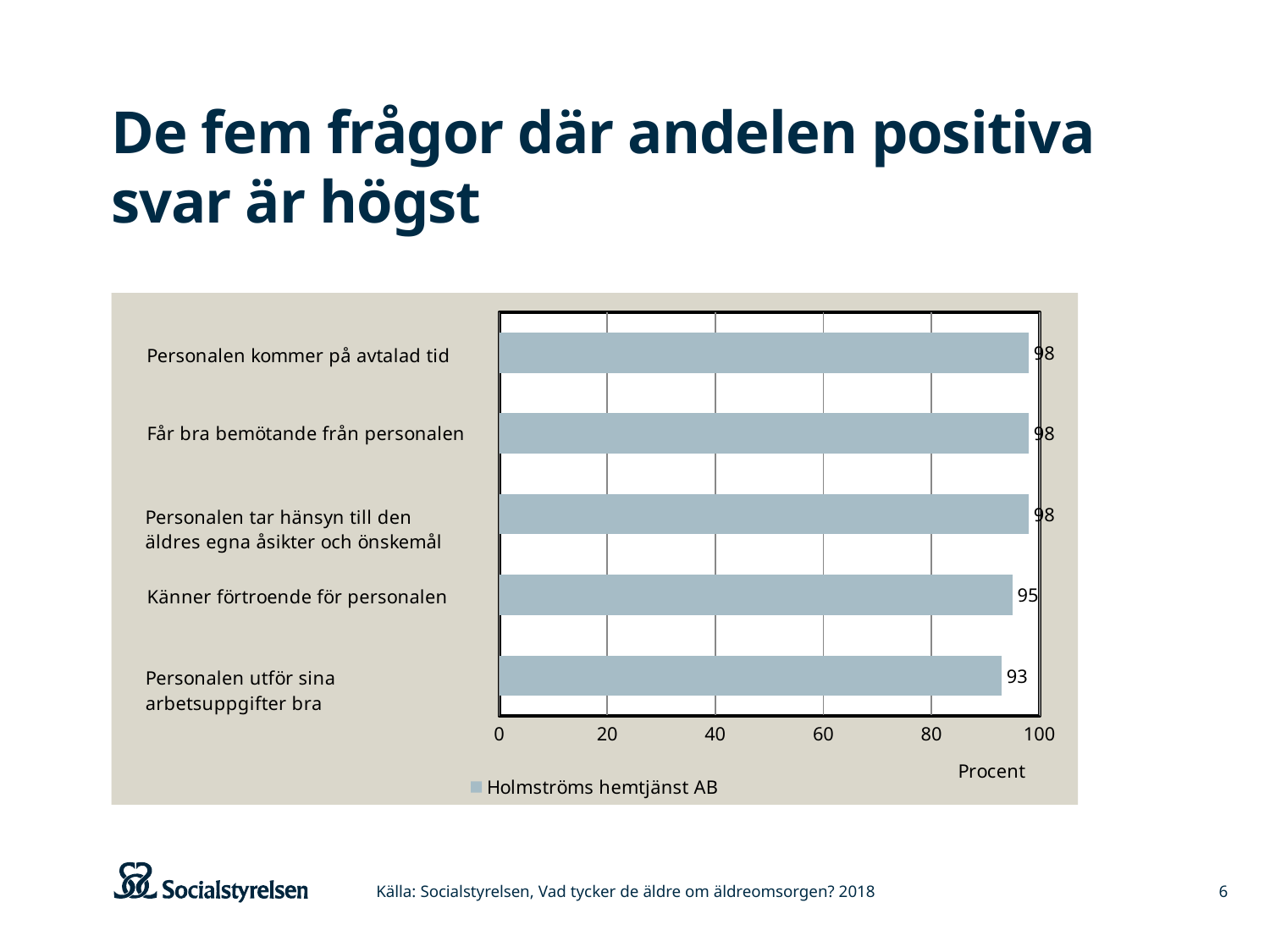
Which category has the lowest value? Personalen utför sina arbetsuppgifter bra Which is larger, the value for "Känner förtroende för personalen" or the value for "Personalen utför sina arbetsuppgifter bra"? Känner förtroende för personalen What is the value for "Får bra bemötande från personalen"? 98 What is the value for "Känner förtroende för personalen"? 95 What is the value for "Personalen kommer på avtalad tid"? 98 What is the difference between the values for "Personalen kommer på avtalad tid" and "Personalen utför sina arbetsuppgifter bra"? 5 What is the difference between the values for "Känner förtroende för personalen" and "Personalen utför sina arbetsuppgifter bra"? 2 How many series does the legend list? 1 What kind of chart is shown on the slide? Bar chart What is the value for "Personalen utför sina arbetsuppgifter bra"? 93 What is the name of the series in the legend? Holmströms hemtjänst AB How many categories are shown in the chart? 5